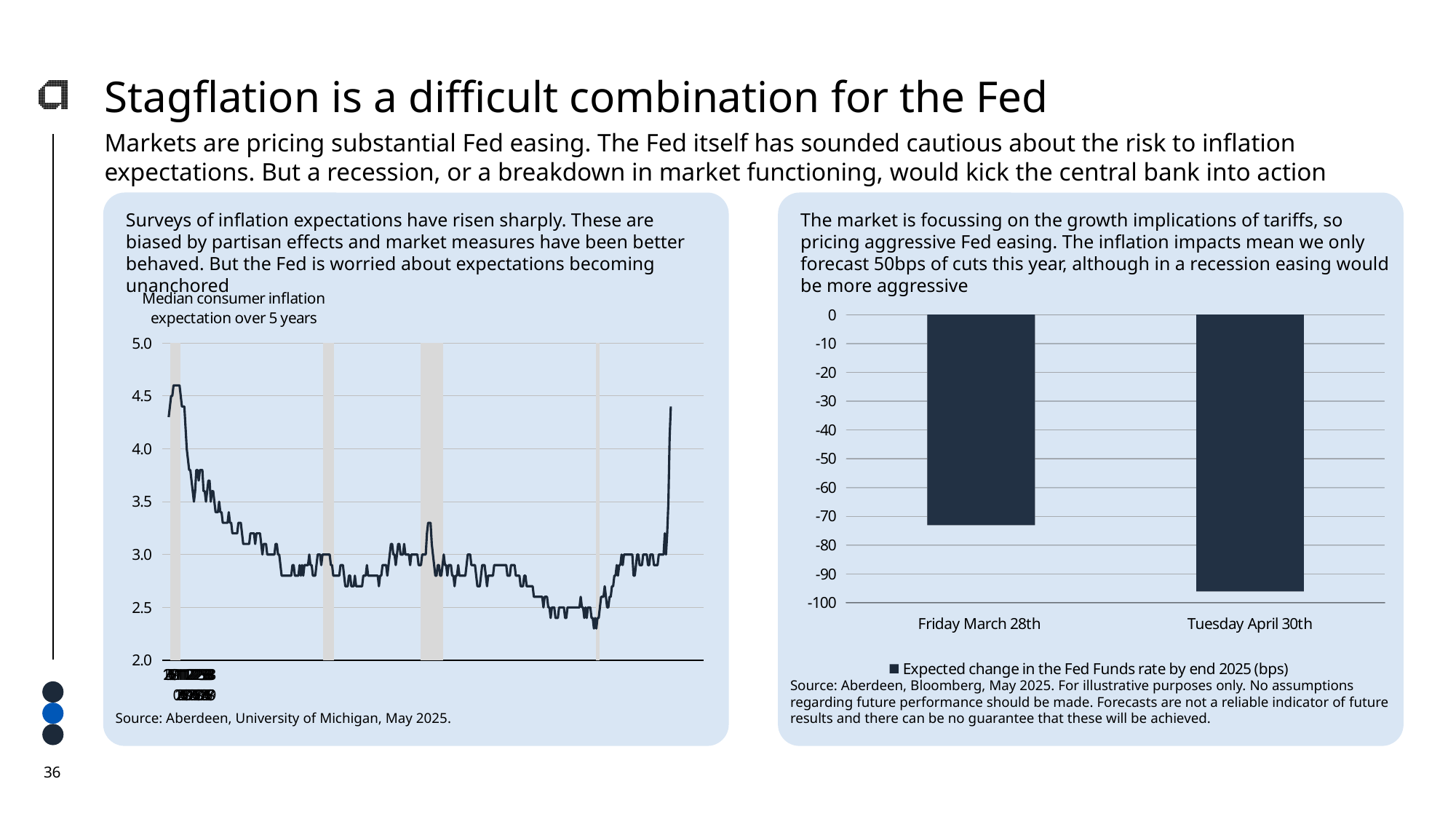
In the bar chart on the right, what is the legend entry for the series? Expected change in the Fed Funds rate by end 2025 (bps) What kind of chart is the chart on the left of the slide? line chart In the bar chart on the right, how many categories are shown on the x axis? 2 In the bar chart on the right, which category has the lowest value? Tuesday April 30th In the line chart on the left, is the final value at the right end of the line greater or less than 4.0? greater What is the title of the line chart on the left? Median consumer inflation expectation over 5 years In the bar chart on the right, is the value for Friday March 28th greater or less than -70? less In the bar chart on the right, which category has the higher value, Friday March 28th or Tuesday April 30th? Friday March 28th In the line chart on the left, is the lowest point of the line greater or less than 2.5? less In the bar chart on the right, how many series does the legend list? 1 What kind of chart is the chart on the right of the slide? bar chart